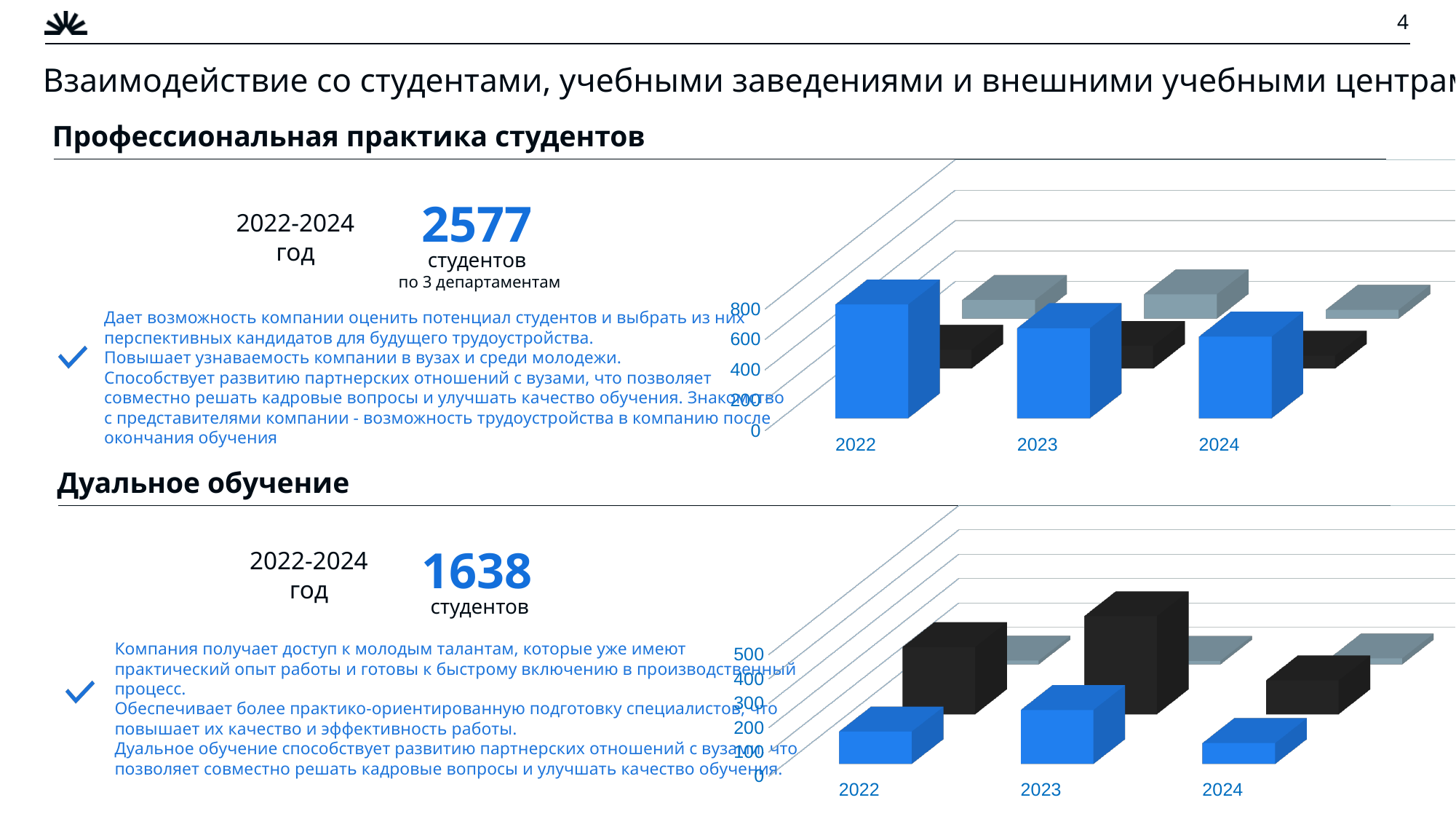
In the chart under «Профессиональная практика студентов», what is the highest value labelled on the vertical axis? 800 In the chart under «Профессиональная практика студентов», how many years are shown on the x axis? 3 In the chart under «Дуальное обучение», which year has the tallest black bar? 2023 What kind of chart is shown under the heading «Дуальное обучение»? bar chart In the chart under «Профессиональная практика студентов», do the blue bars rise or fall from 2022 to 2024? fall In the chart under «Дуальное обучение», is the black bar for 2023 taller or shorter than the black bar for 2024? taller In the chart under «Профессиональная практика студентов», which year has the lowest grey bar? 2024 In the chart under «Дуальное обучение», how many years are shown on the x axis? 3 In the chart under «Дуальное обучение», which year has the lowest blue bar? 2024 What kind of chart is shown under the heading «Профессиональная практика студентов»? bar chart In the chart under «Дуальное обучение», what is the highest value labelled on the vertical axis? 500 In the chart under «Профессиональная практика студентов», which year has the tallest blue bar? 2022